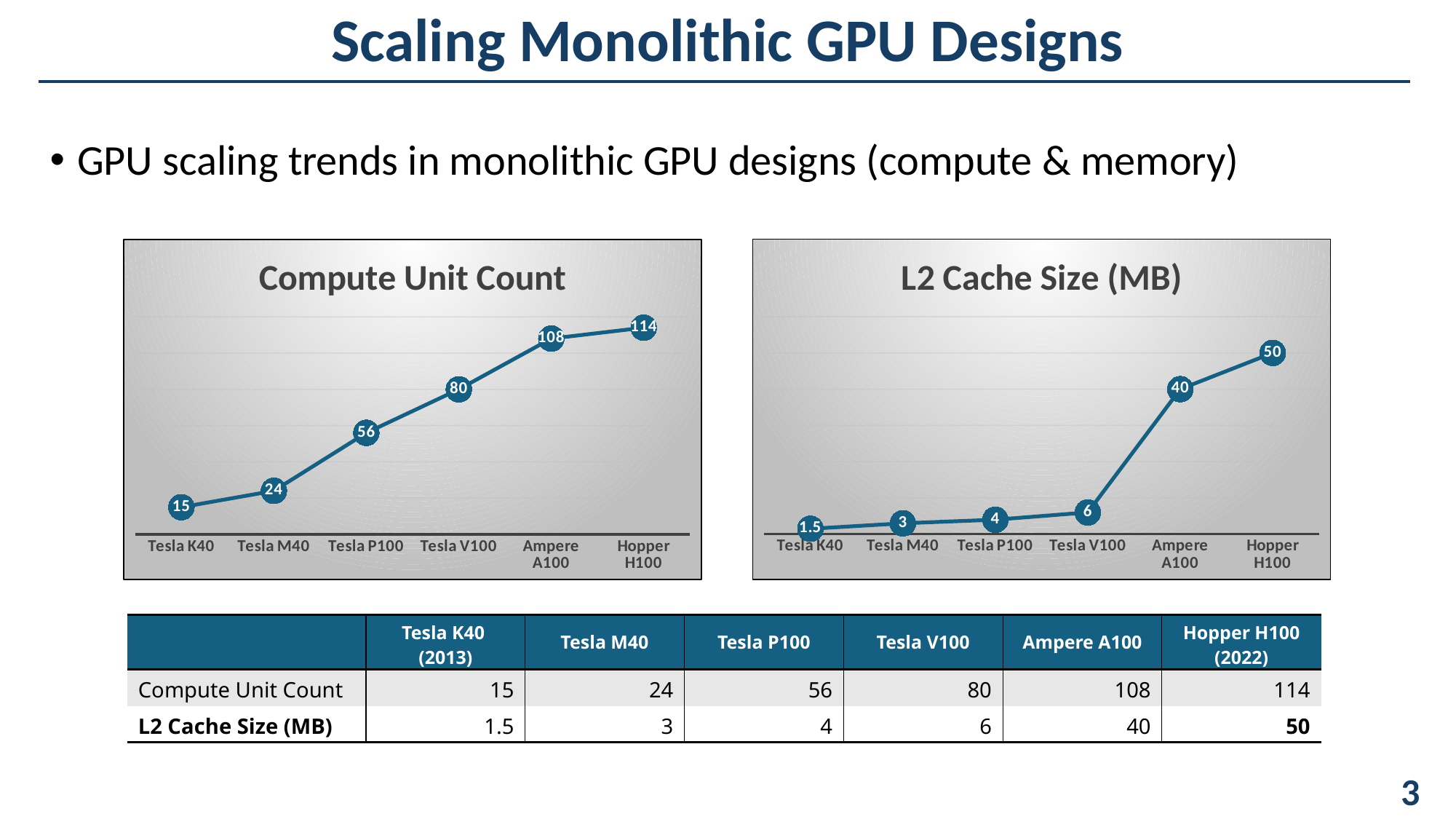
In the L2 Cache Size (MB) chart, which GPU has the lowest value? Tesla K40 In the L2 Cache Size (MB) chart, which is larger, the value for Tesla V100 or Tesla M40? Tesla V100 In the L2 Cache Size (MB) chart, what is the value for Ampere A100? 40 What is the title of the chart on the left side of the slide? Compute Unit Count In the L2 Cache Size (MB) chart, what is the difference between Hopper H100 and Ampere A100? 10 In the Compute Unit Count chart, what is the value for Tesla P100? 56 In the Compute Unit Count chart, do the values rise or fall from Tesla K40 to Hopper H100? Rise In the Compute Unit Count chart, which GPU has the highest value? Hopper H100 In the Compute Unit Count chart, what is the difference between Ampere A100 and Tesla V100? 28 In the L2 Cache Size (MB) chart, what is the value for Tesla K40? 1.5 What kind of chart is the L2 Cache Size (MB) chart? Line chart How many GPUs are plotted in the Compute Unit Count chart? 6